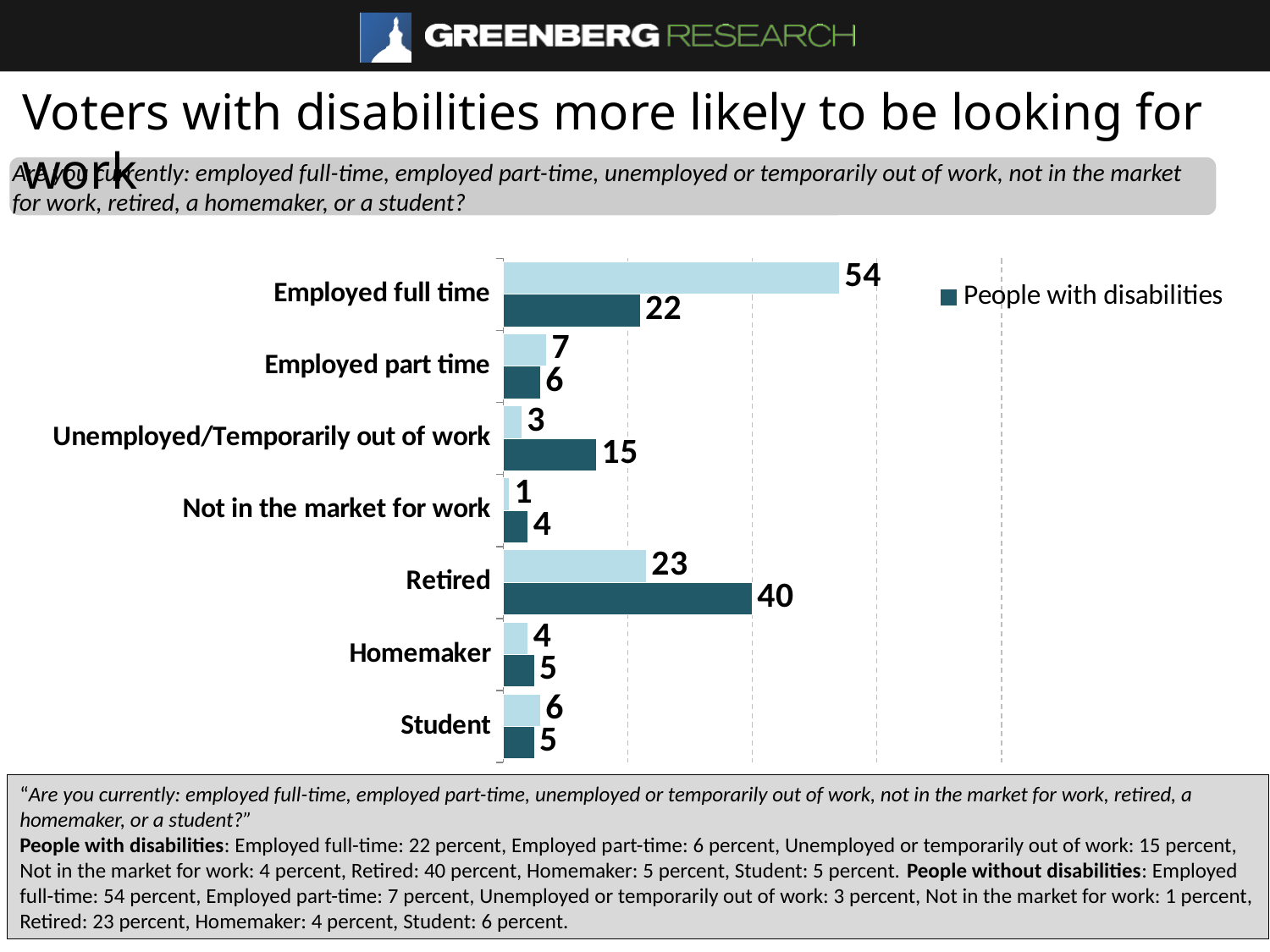
What series name is shown in the chart legend? People with disabilities How many categories are shown on the chart? 7 In the Unemployed/Temporarily out of work category, which bar is larger: the People with disabilities bar or the lighter blue bar? People with disabilities What value does the lighter blue bar show for Employed full time? 54 In the Retired category, what is the difference between the People with disabilities bar (40) and the lighter blue bar (23)? 17 What is the value for People with disabilities in the Retired category? 40 In the Employed full time category, what is the difference between the lighter blue bar (54) and the People with disabilities bar (22)? 32 What kind of chart is shown on the slide? Bar chart What is the value for People with disabilities in the Unemployed/Temporarily out of work category? 15 What is the value for People with disabilities in the Employed full time category? 22 Which category has the lowest value for People with disabilities? Not in the market for work Which category has the highest value for People with disabilities? Retired